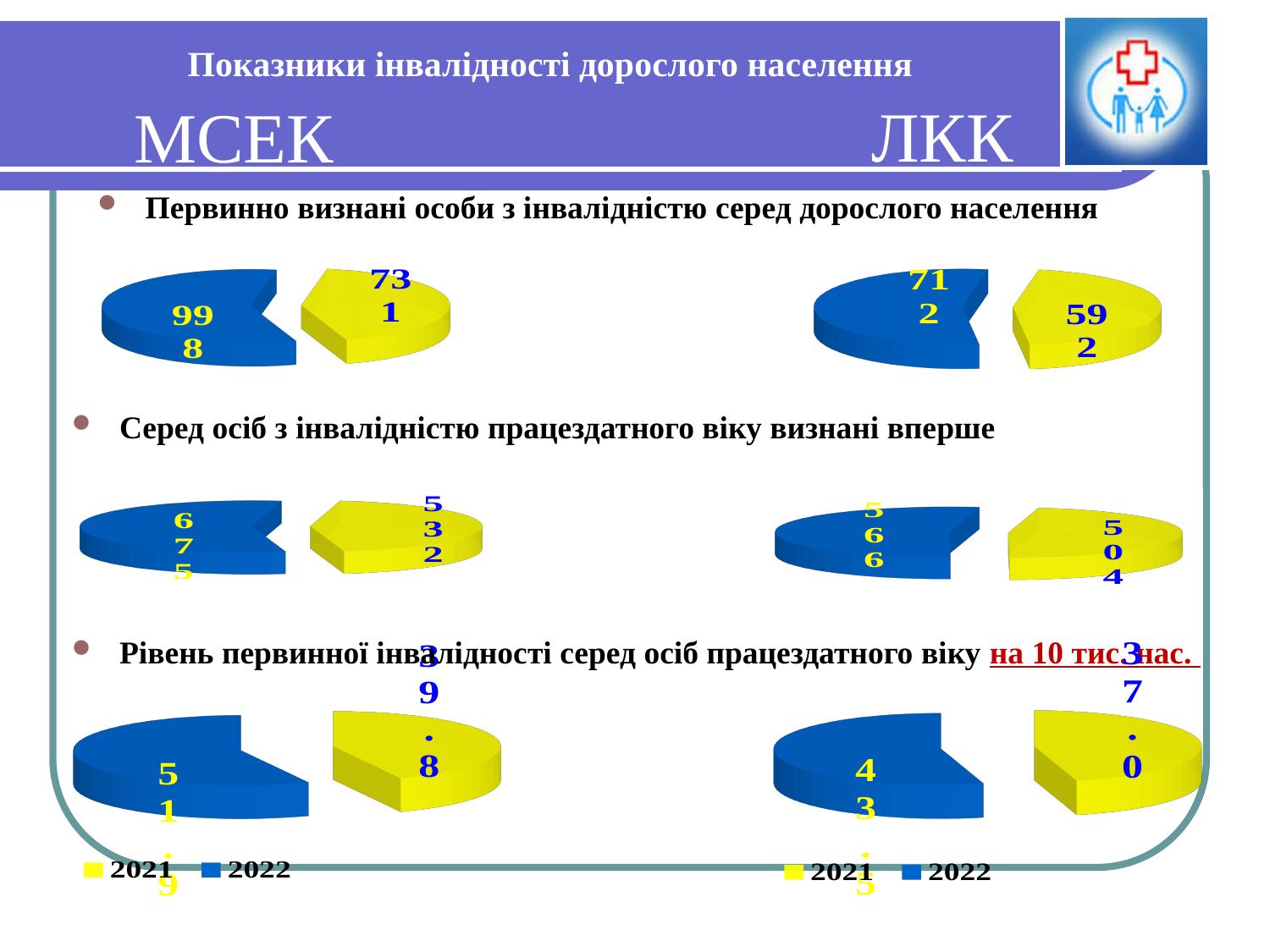
In the МСЕК pie chart for 'Первинно визнані особи з інвалідністю серед дорослого населення', what is the total of the two slices? 1729 In the МСЕК pie chart for 'Рівень первинної інвалідності серед осіб працездатного віку на 10 тис.нас.', what is the value for 2022? 51.9 In the МСЕК pie chart for 'Серед осіб з інвалідністю працездатного віку визнані вперше', what is the difference between the 2022 and 2021 values? 143 Which colour represents 2021 in the legend? Yellow In the МСЕК pie chart for 'Первинно визнані особи з інвалідністю серед дорослого населення', what is the value for 2021 (yellow slice)? 731 In the ЛКК pie chart for 'Серед осіб з інвалідністю працездатного віку визнані вперше', which year has the larger value, 2021 or 2022? 2022 In the ЛКК pie chart for 'Первинно визнані особи з інвалідністю серед дорослого населення', what is the value for 2021? 592 In the ЛКК pie chart for 'Рівень первинної інвалідності серед осіб працездатного віку на 10 тис.нас.', what is the value for 2021? 37.0 What kind of chart is used on this slide? Pie chart How many series does the legend list for each chart? 2 In the ЛКК pie chart for 'Первинно визнані особи з інвалідністю серед дорослого населення', what is the value for 2022? 712 In the МСЕК pie chart for 'Первинно визнані особи з інвалідністю серед дорослого населення', what is the value for 2022 (blue slice)? 998